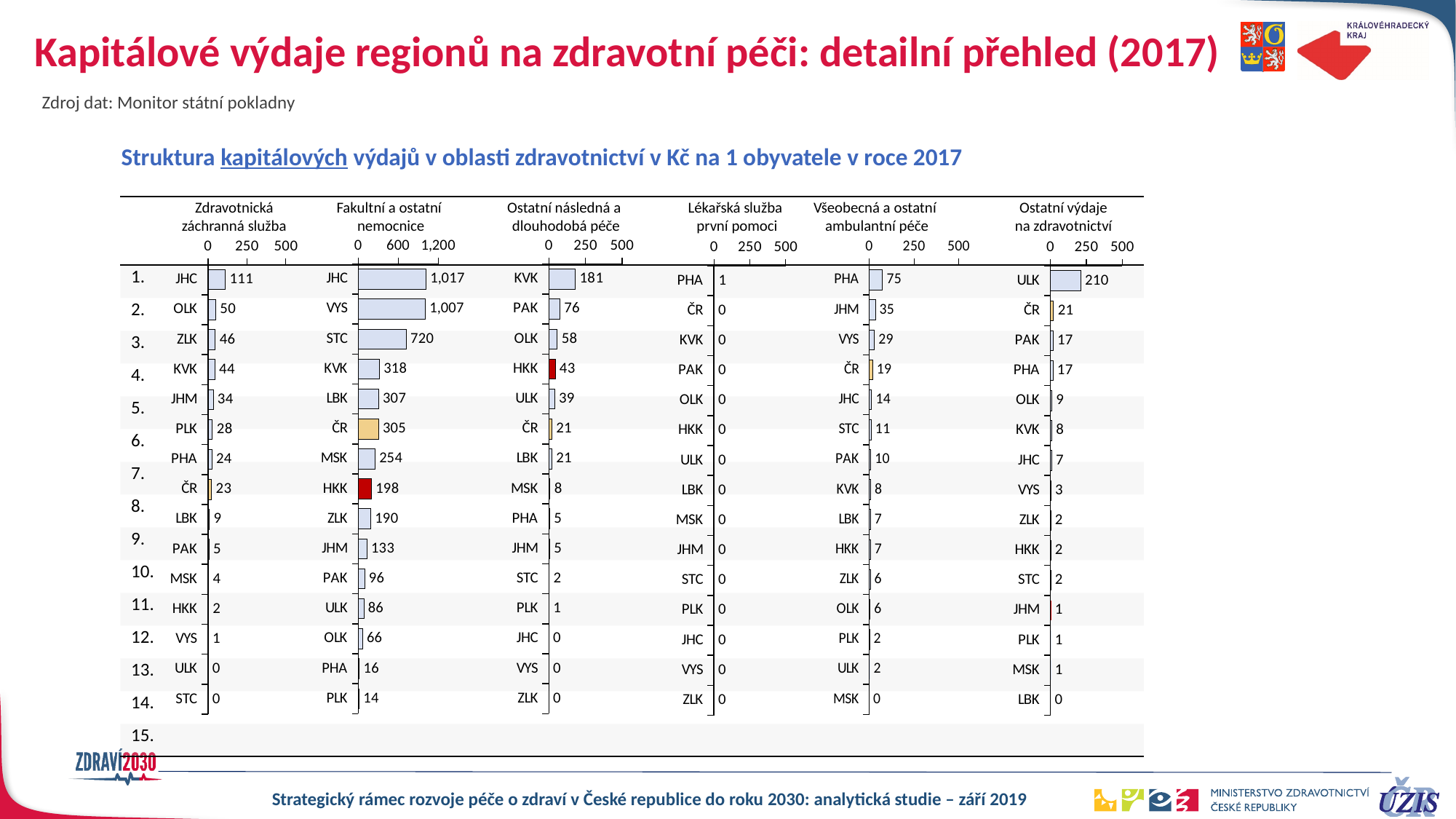
In the 'Fakultní a ostatní nemocnice' chart, what is the difference between the values for JHC and VYS? 10 How many separate chart panels are shown on the slide? 6 How many categories (rows) are plotted in the 'Lékařská služba první pomoci' chart? 15 In the 'Fakultní a ostatní nemocnice' chart, what is the value for JHC? 1,017 In the 'Fakultní a ostatní nemocnice' chart, is the value for STC greater or less than 600? greater In the 'Ostatní výdaje na zdravotnictví' chart, which region has the highest value? ULK In the 'Všeobecná a ostatní ambulantní péče' chart, which region has the lowest value? MSK In the 'Lékařská služba první pomoci' chart, what is the value for PHA? 1 What kind of chart is used in the 'Ostatní výdaje na zdravotnictví' panel? bar chart In the 'Ostatní následná a dlouhodobá péče' chart, which region has the highest value? KVK In the 'Zdravotnická záchranná služba' chart, which is larger, the value for JHC or the value for OLK? JHC In the 'Zdravotnická záchranná služba' chart, what is the value for HKK? 2